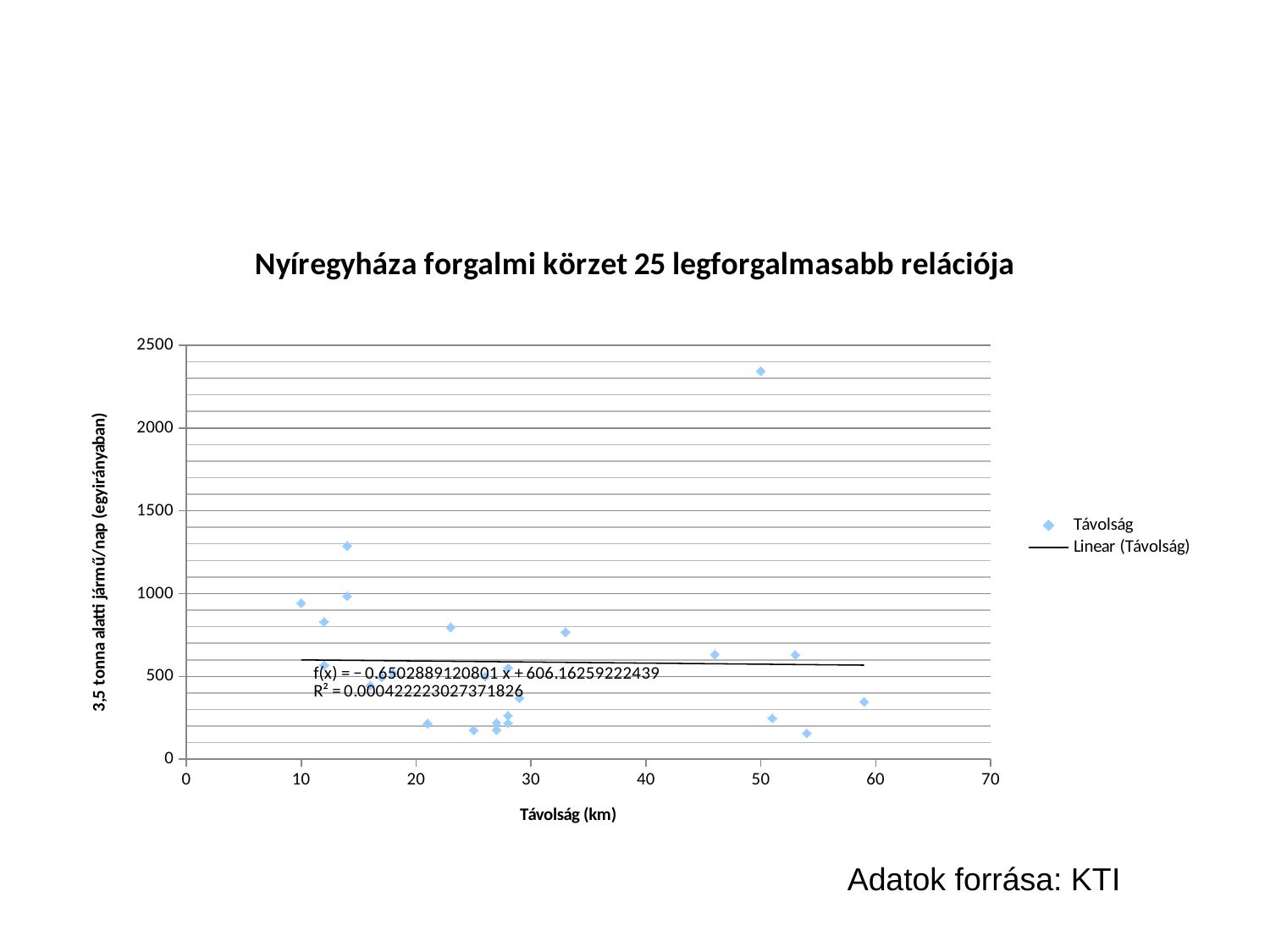
What R² value is printed on the chart for the linear trendline? R² = 0.000422223027371826 How many entries does the chart's legend list? 2 Does the linear trendline rise or fall as distance increases? Falls (slightly) Is the value of the point at 50 km greater or less than 2000? greater What kind of chart is shown on the slide? Scatter chart Is the value of the point at 59 km greater or less than 500? less Which point has the larger value: the one at 10 km or the one at 59 km? 10 km Is the value of the point at 54 km greater or less than 500? less At which distance (km) does the point with the highest vehicles-per-day value appear? 50 What is the title of the chart? Nyíregyháza forgalmi körzet 25 legforgalmasabb relációja